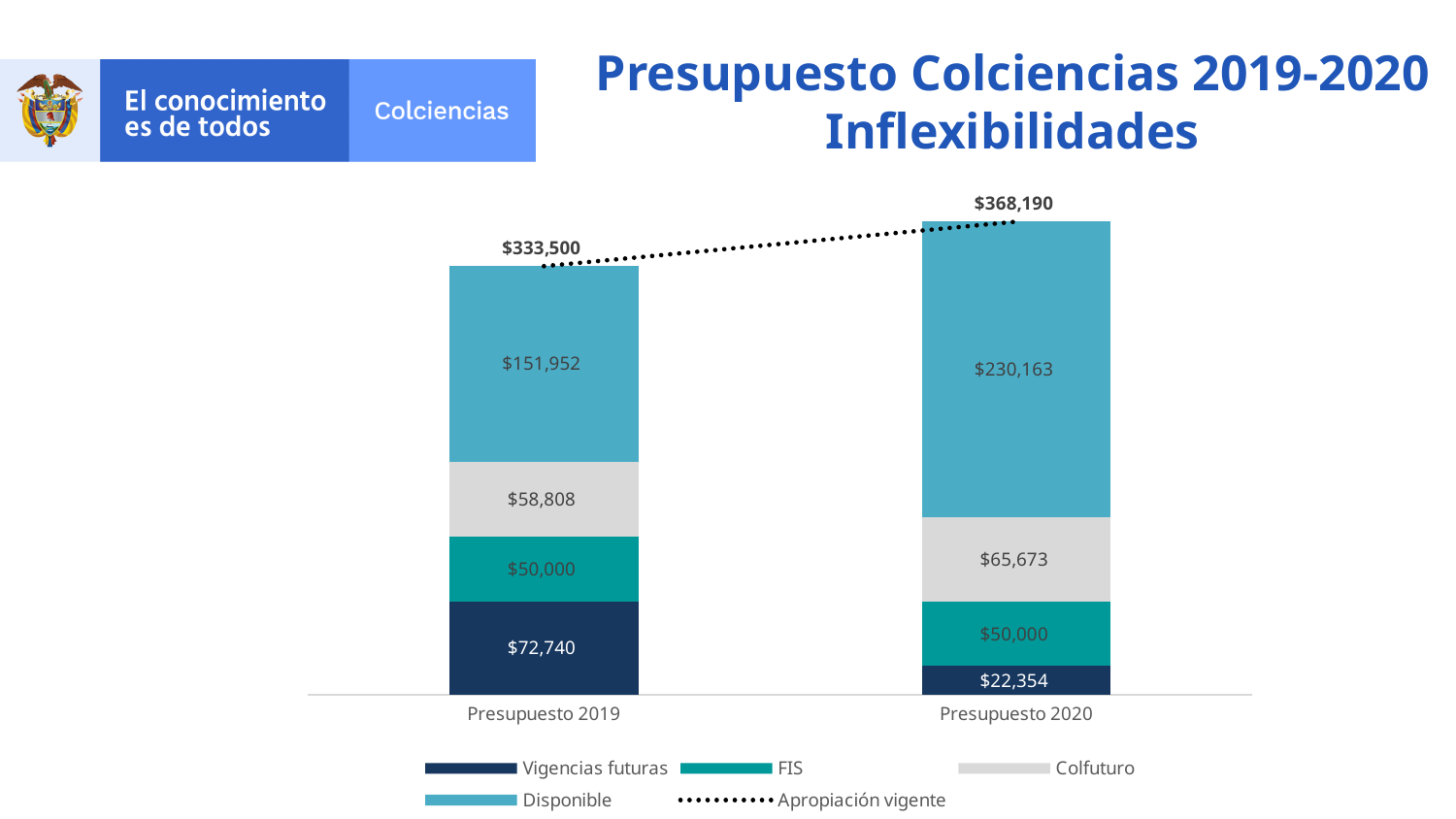
Which segment is the smallest in the Presupuesto 2020 bar? Vigencias futuras What is the value of Colfuturo for Presupuesto 2020? $65,673 Does the Apropiación vigente line rise or fall from Presupuesto 2019 to Presupuesto 2020? rise What is the value of Vigencias futuras for Presupuesto 2020? $22,354 What is the Apropiación vigente value for Presupuesto 2019? $333,500 What is the value of Disponible for Presupuesto 2019? $151,952 Which segment is the largest in the Presupuesto 2019 bar? Disponible What is the difference between the Vigencias futuras values for Presupuesto 2019 and Presupuesto 2020? $50,386 Which is larger, Colfuturo for Presupuesto 2019 or Colfuturo for Presupuesto 2020? Presupuesto 2020 How many series does the legend list? 5 What is the total of the stacked bar for Presupuesto 2020? $368,190 What is the difference between the Disponible values for Presupuesto 2020 and Presupuesto 2019? $78,211